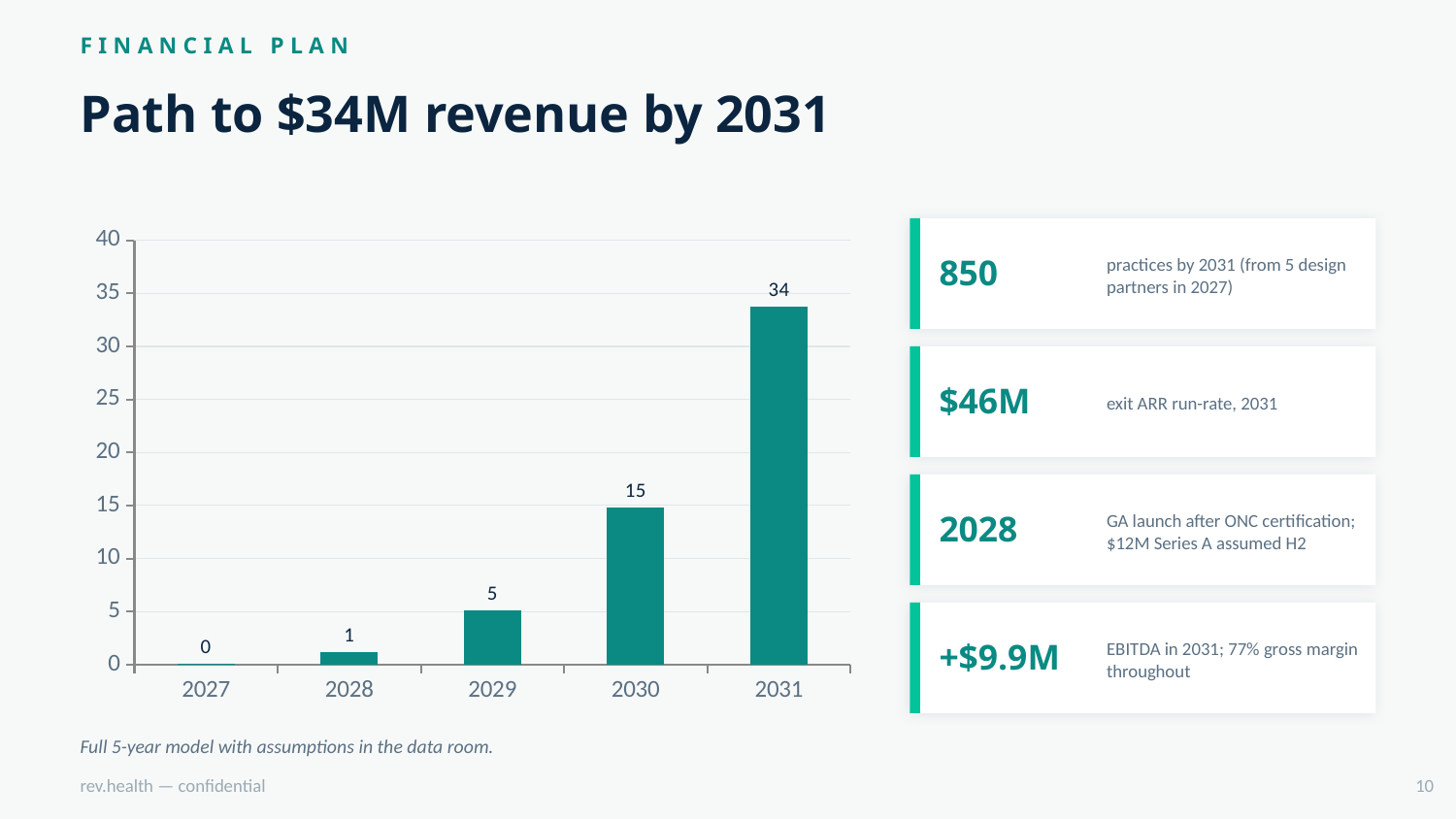
Which year has the highest value? 2031 Do the values rise or fall from 2027 to 2031? rise How many years are shown on the x axis? 5 Is the value for 2031 greater or less than 30? greater What is the value for 2031? 34 Which is larger, the value for 2029 or the value for 2030? 2030 Which year has the lowest value? 2027 What is the value for 2029? 5 What is the difference between the values for 2031 and 2030? 19 What kind of chart is shown on the slide? bar chart What is the value for 2030? 15 What is the value for 2028? 1